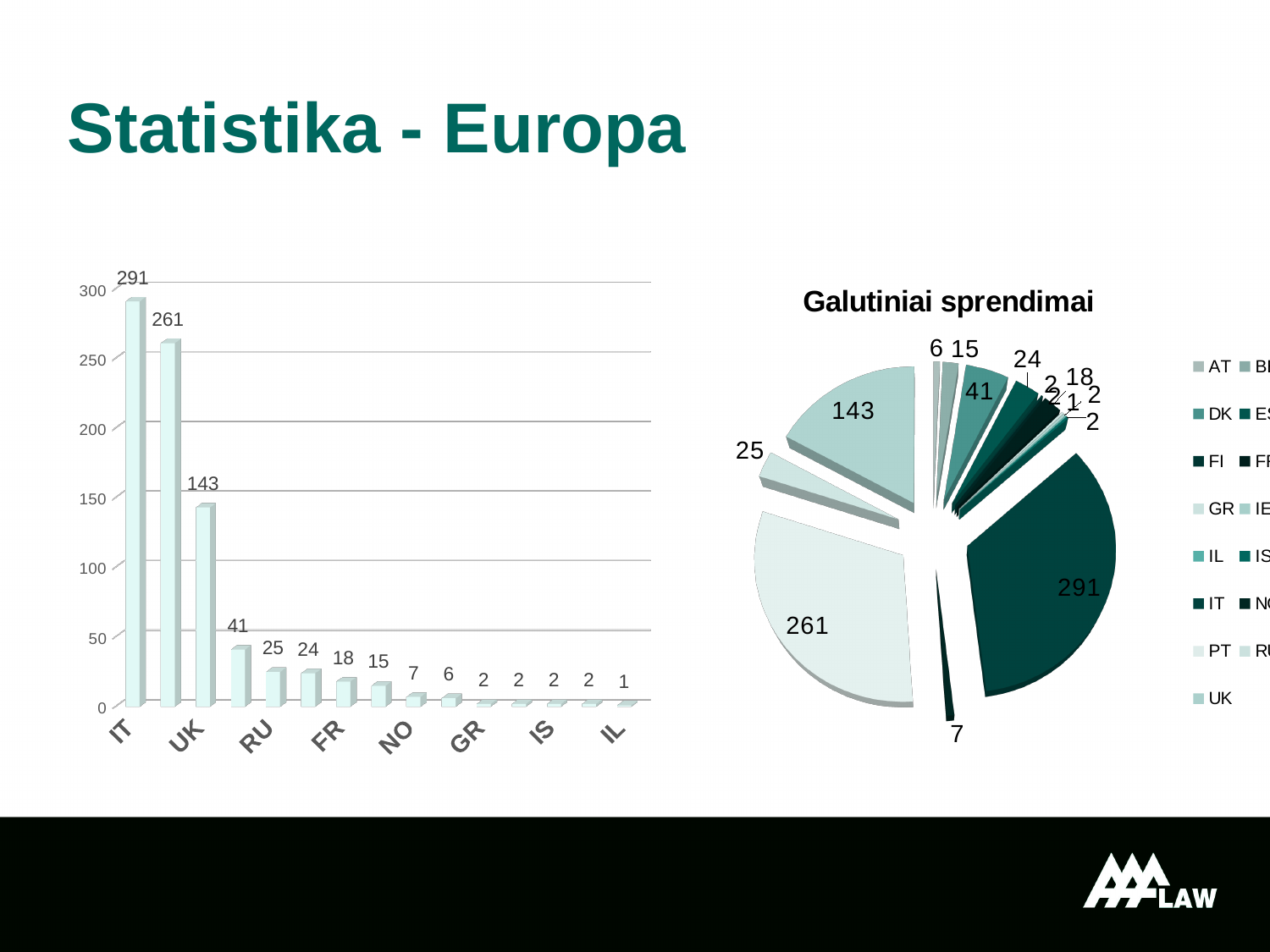
In the bar chart on the left, what is the value for RU? 25 In the bar chart on the left, which is larger, the value for IT or the value for UK? IT In the bar chart on the left, do the values rise or fall from left to right along the x axis? fall What kind of chart is the chart on the left of the slide? bar chart In the bar chart on the left, which labelled category has the lowest value? IL In the bar chart on the left, what is the value for UK? 143 How many bars are plotted in the bar chart on the left? 15 In the bar chart on the left, what is the difference between the values for IT and UK? 148 What is the title of the pie chart on the right of the slide? Galutiniai sprendimai In the bar chart on the left, which category has the highest value? IT In the bar chart on the left, what is the value for IT? 291 In the pie chart titled 'Galutiniai sprendimai', what is the value of the largest slice? 291